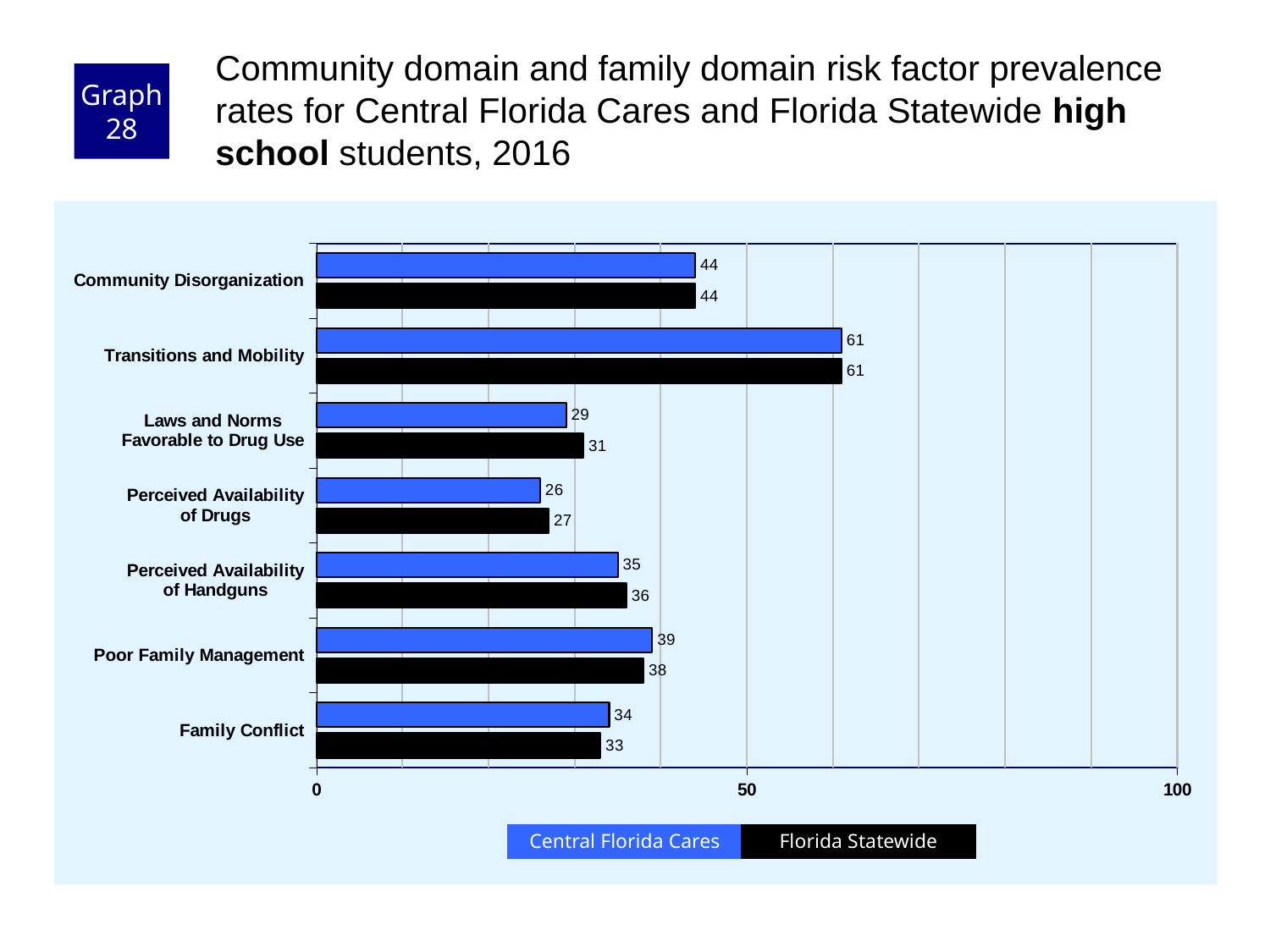
Is the Central Florida Cares value for Transitions and Mobility greater or less than 50? greater What is the Central Florida Cares value for Transitions and Mobility? 61 Which colour represents Florida Statewide in the chart? black Which risk factor has the lowest Florida Statewide value? Perceived Availability of Drugs Which risk factor has the highest Central Florida Cares value? Transitions and Mobility How many risk factors are shown on the chart? 7 How many series does the legend list? 2 What is the Central Florida Cares value for Family Conflict? 34 What is the Florida Statewide value for Laws and Norms Favorable to Drug Use? 31 What kind of chart is shown on the slide? bar chart Which is larger for Poor Family Management: the Central Florida Cares value or the Florida Statewide value? Central Florida Cares What is the difference between the Florida Statewide and Central Florida Cares values for Laws and Norms Favorable to Drug Use? 2